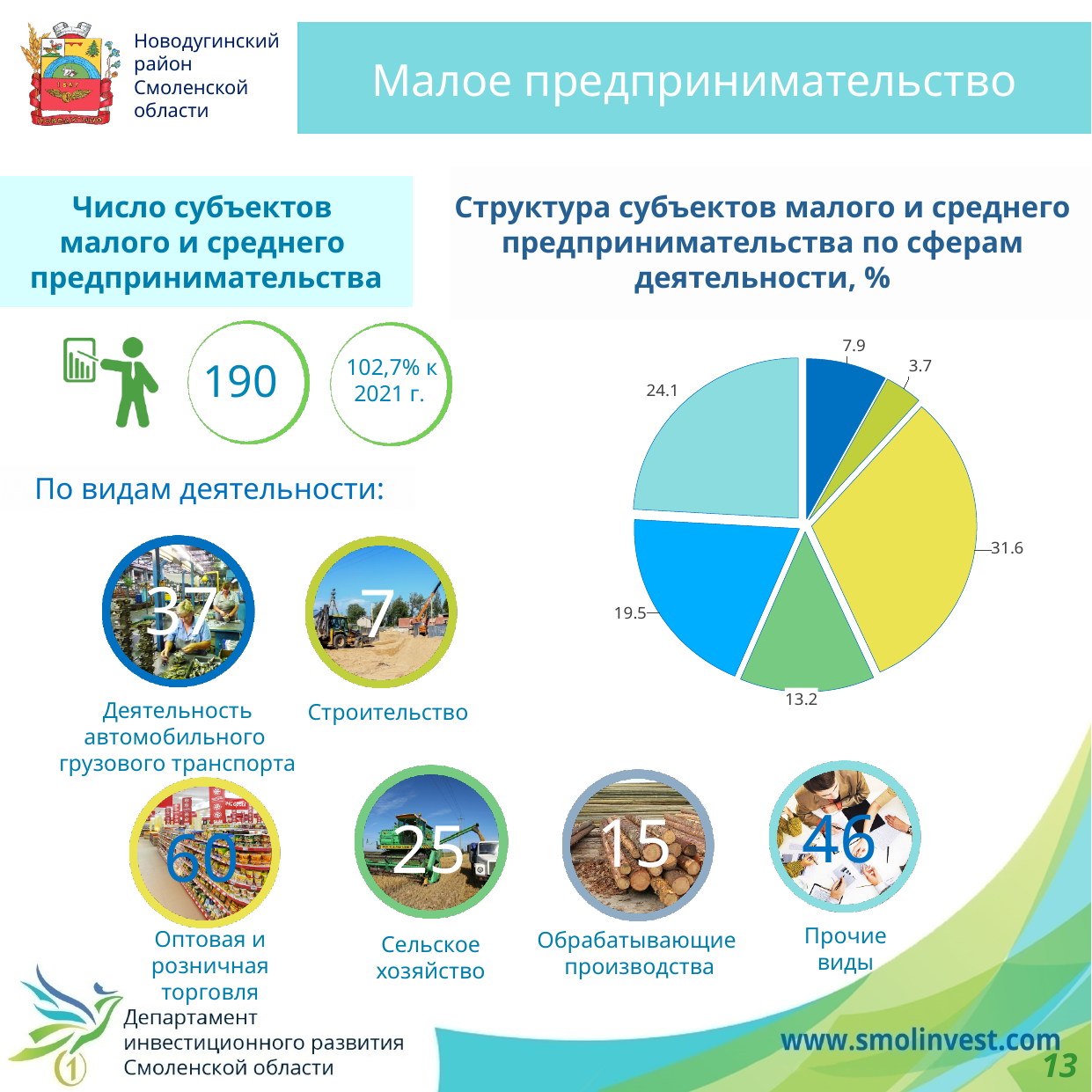
What value is shown for the yellow slice of the pie chart? 31.6 What is the sum of all the slice values shown in the pie chart? 100 In the pie chart, which is larger: the slice labelled 24.1 or the slice labelled 19.5? 24.1 How many slices does the pie chart have? 6 What value is shown for the dark blue slice of the pie chart? 7.9 What is the value of the smallest slice in the pie chart? 3.7 What is the title of the pie chart on the slide? Структура субъектов малого и среднего предпринимательства по сферам деятельности, % In the pie chart, what is the difference between the slices labelled 19.5 and 13.2? 6.3 What kind of chart is shown under the title "Структура субъектов малого и среднего предпринимательства по сферам деятельности, %"? pie chart What is the value of the largest slice in the pie chart? 31.6 In the pie chart, what is the difference between the largest slice (31.6) and the slice labelled 24.1? 7.5 Does the pie chart include a legend identifying the slices? No